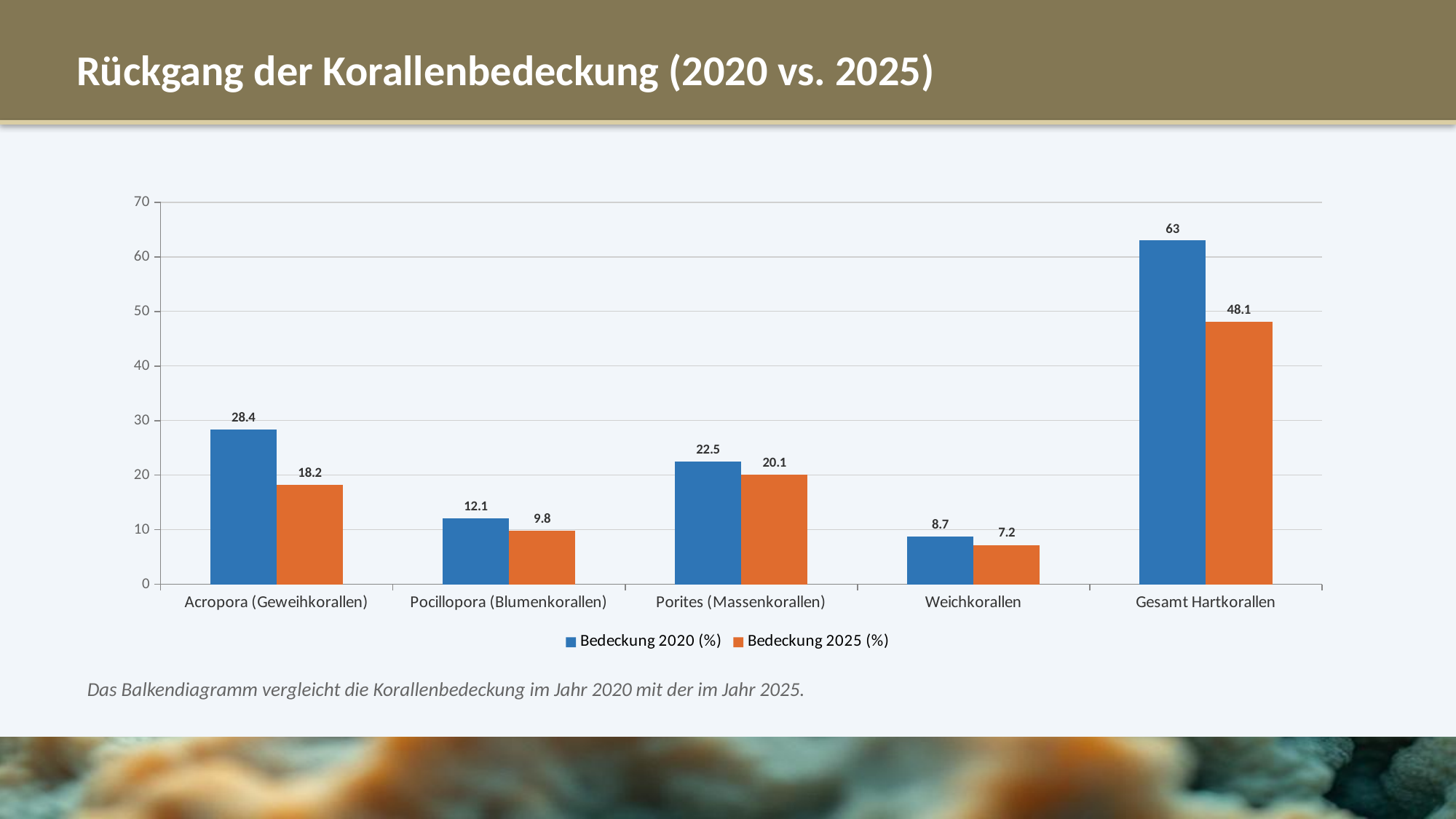
What is the Bedeckung 2025 (%) value for Weichkorallen? 7.2 What is the difference between the Bedeckung 2020 (%) and Bedeckung 2025 (%) values for Gesamt Hartkorallen? 14.9 Which is larger: the Bedeckung 2025 (%) value for Porites (Massenkorallen) or the Bedeckung 2020 (%) value for Pocillopora (Blumenkorallen)? Bedeckung 2025 (%) for Porites (Massenkorallen) Which category has the lowest Bedeckung 2025 (%) value? Weichkorallen What is the difference between the Bedeckung 2020 (%) and Bedeckung 2025 (%) values for Acropora (Geweihkorallen)? 10.2 What is the title of the chart on the slide? Rückgang der Korallenbedeckung (2020 vs. 2025) What is the Bedeckung 2025 (%) value for Gesamt Hartkorallen? 48.1 What is the Bedeckung 2020 (%) value for Acropora (Geweihkorallen)? 28.4 How many categories are shown on the x axis? 5 How many series does the legend list? 2 Which category has the highest Bedeckung 2020 (%) value? Gesamt Hartkorallen What kind of chart is shown on the slide? Bar chart